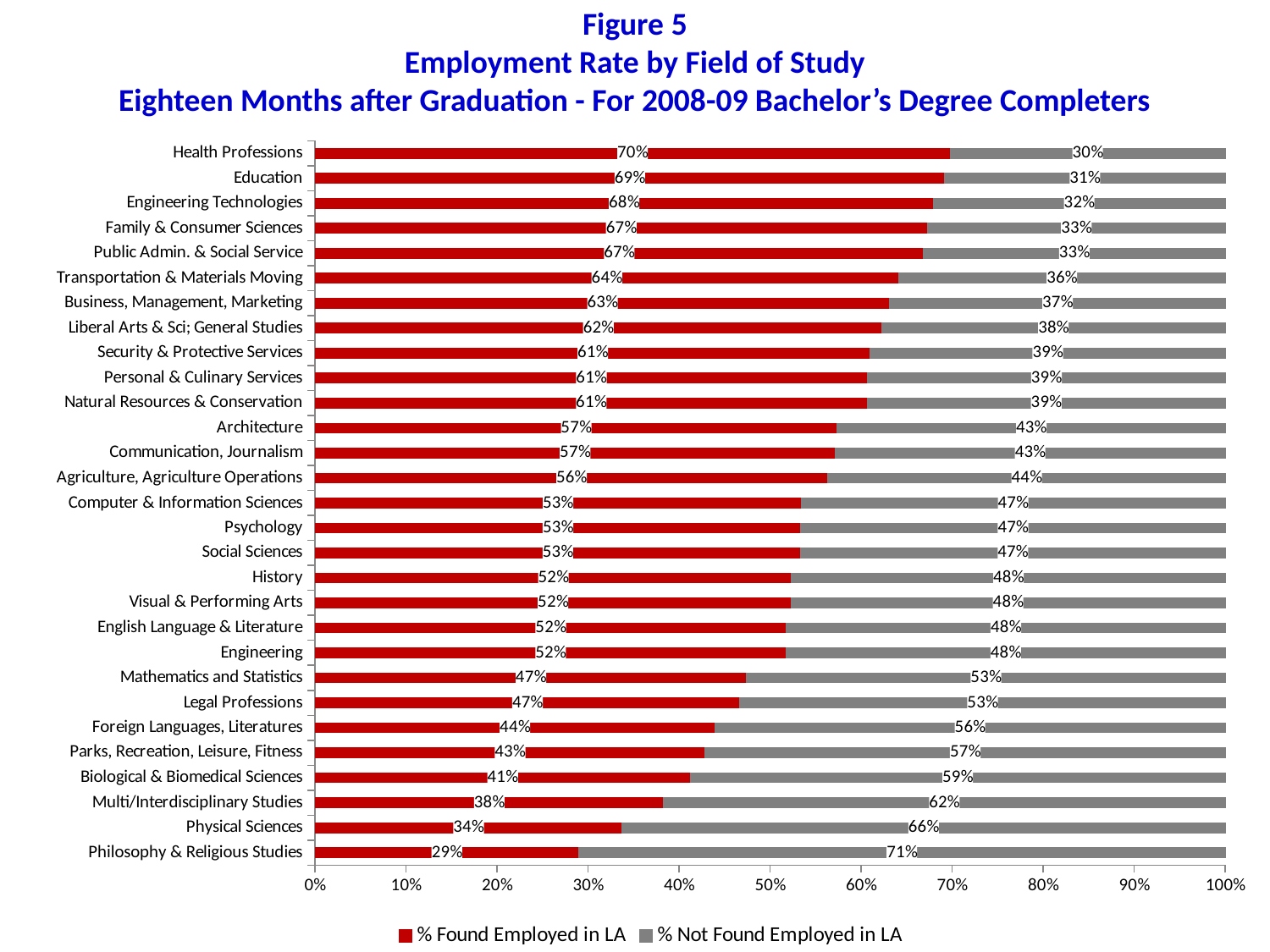
What is the total of the stacked bar for Multi/Interdisciplinary Studies? 100% What is the % Found Employed in LA for Health Professions? 70% Which field of study has the lowest % Found Employed in LA? Philosophy & Religious Studies Which has a higher % Found Employed in LA, Architecture or Legal Professions? Architecture What is the % Not Found Employed in LA for Physical Sciences? 66% What kind of chart is shown on the slide? Stacked bar chart What is the % Found Employed in LA for Psychology? 53% How many series does the legend list? 2 How many fields of study are shown in the chart? 29 What colour represents % Found Employed in LA in the chart? Red Which field of study has the highest % Found Employed in LA? Health Professions What is the difference in % Found Employed in LA between Education and Engineering? 17%